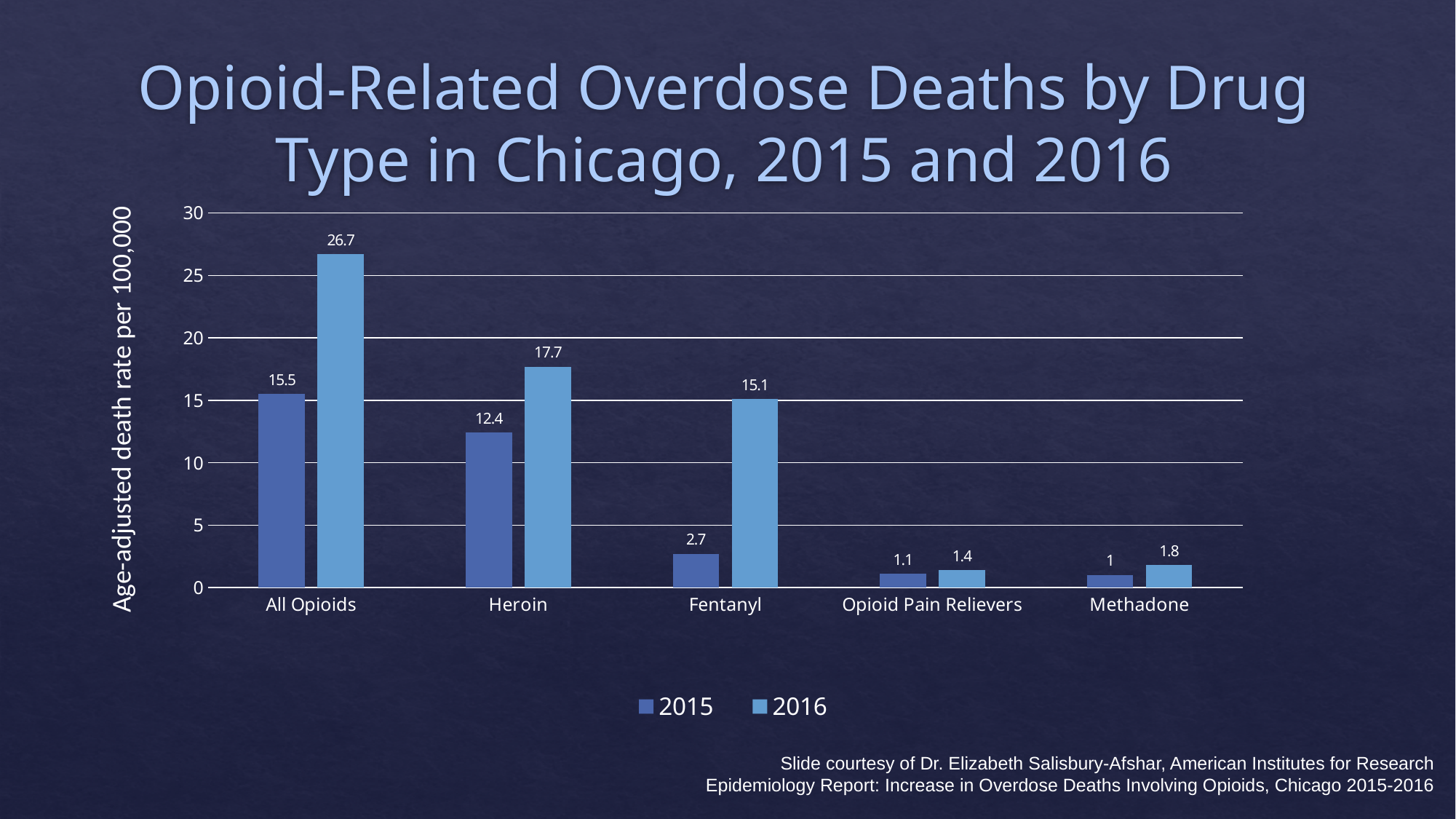
What is the difference between the 2016 and 2015 death rates for Fentanyl? 12.4 How many drug type categories are shown on the x axis? 5 Which is larger, the 2016 value for Heroin or the 2016 value for Fentanyl? 2016 value for Heroin Is the 2016 value for All Opioids greater or less than 25? greater What is the 2016 value for Methadone? 1.8 Which drug type has the highest 2016 death rate? All Opioids What is the 2016 age-adjusted death rate for All Opioids? 26.7 What is the 2015 value for Fentanyl? 2.7 What kind of chart is shown on the slide? Bar chart Which drug type has the lowest 2015 death rate? Methadone How many series does the legend list? 2 What is the 2015 age-adjusted death rate for Heroin? 12.4